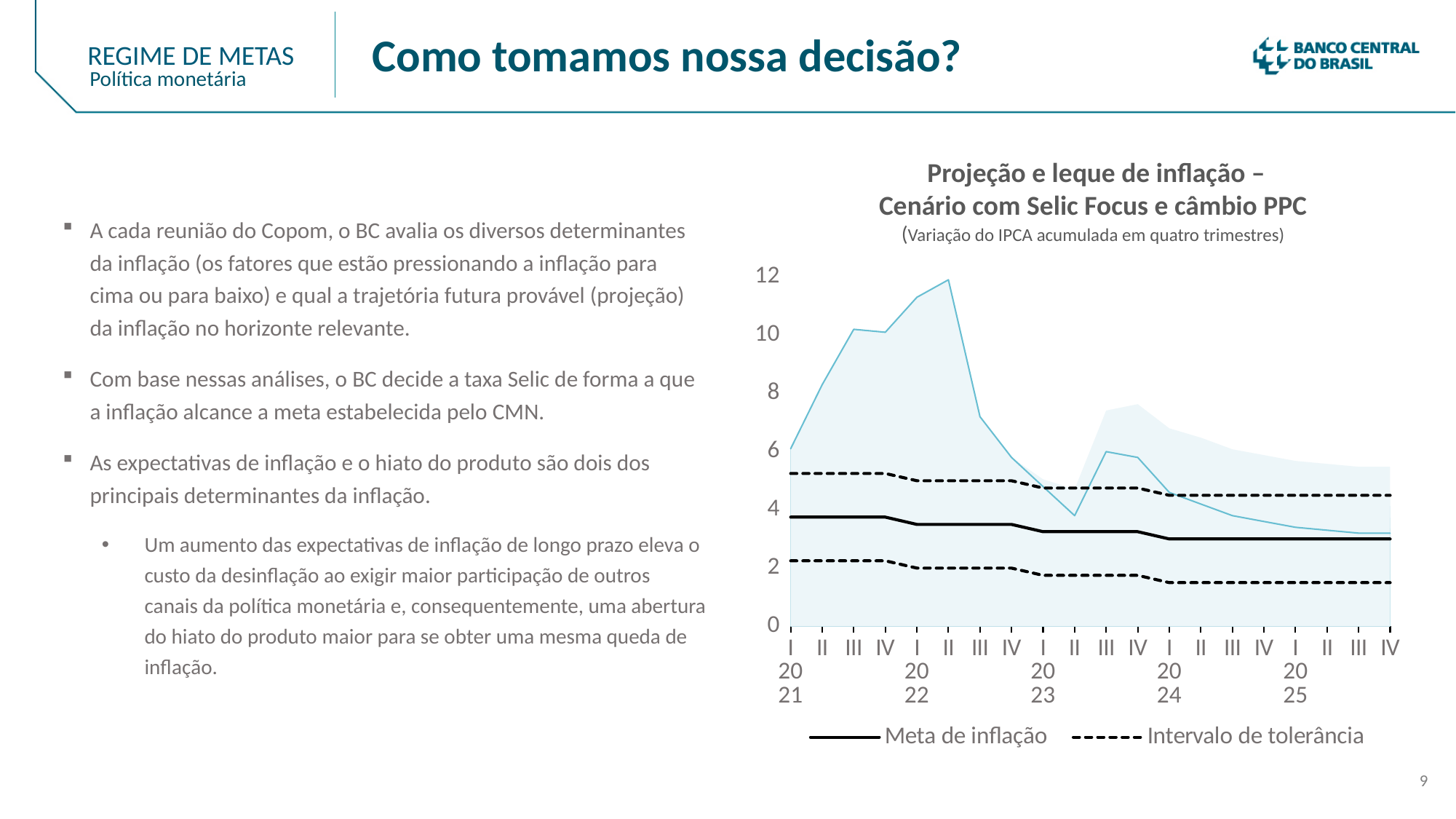
What are the two entries in the chart legend? Meta de inflação and Intervalo de tolerância Is the upper Intervalo de tolerância line in I 2021 greater or less than 4? greater Does the inflation projection line rise or fall between II 2022 and II 2023? fall How many quarterly points are shown along the x axis? 20 Does the Meta de inflação line rise or fall from 2021 to 2025? fall Is the lower Intervalo de tolerância line in IV 2025 greater or less than 2? less What kind of chart is shown on the slide? area and line chart In which quarter does the inflation projection line reach its highest value? II 2022 Is the value of the inflation projection in III 2022 greater or less than 6? greater How many series does the legend list? 2